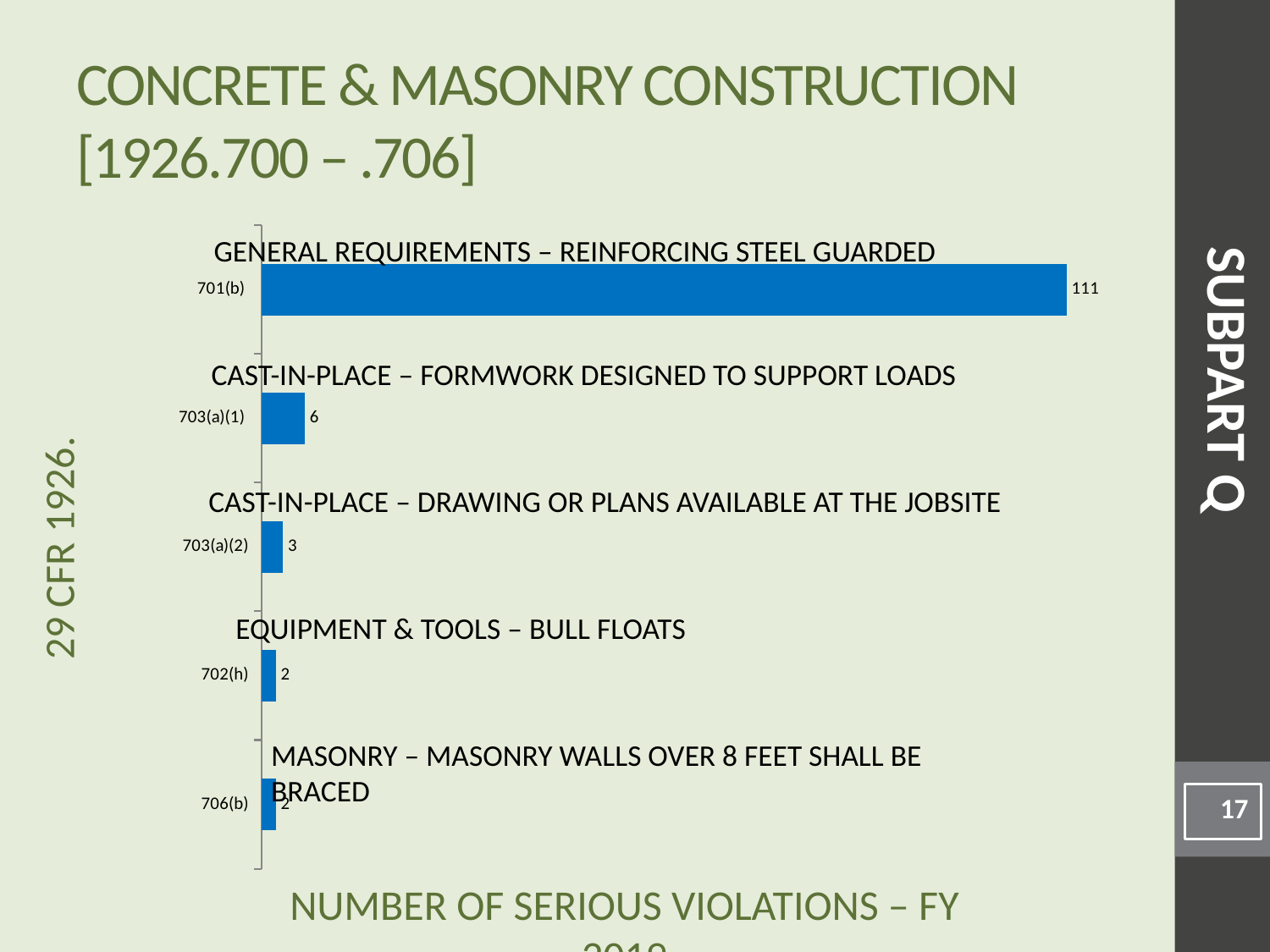
What is the total number of serious violations across all five standards shown? 124 What is the number of serious violations for 703(a)(2)? 3 Which standard is described as 'EQUIPMENT & TOOLS – BULL FLOATS'? 702(h) Which has more serious violations, 703(a)(1) or 703(a)(2)? 703(a)(1) What kind of chart is shown on the slide? Bar chart What is the difference in serious violations between 703(a)(1) and 703(a)(2)? 3 Which standard has the highest number of serious violations? 701(b) What is the number of serious violations for 703(a)(1)? 6 What is the number of serious violations for 701(b)? 111 What is the difference in serious violations between 701(b) and 703(a)(1)? 105 What is the number of serious violations for 702(h)? 2 How many standards (categories) are shown in the chart? 5